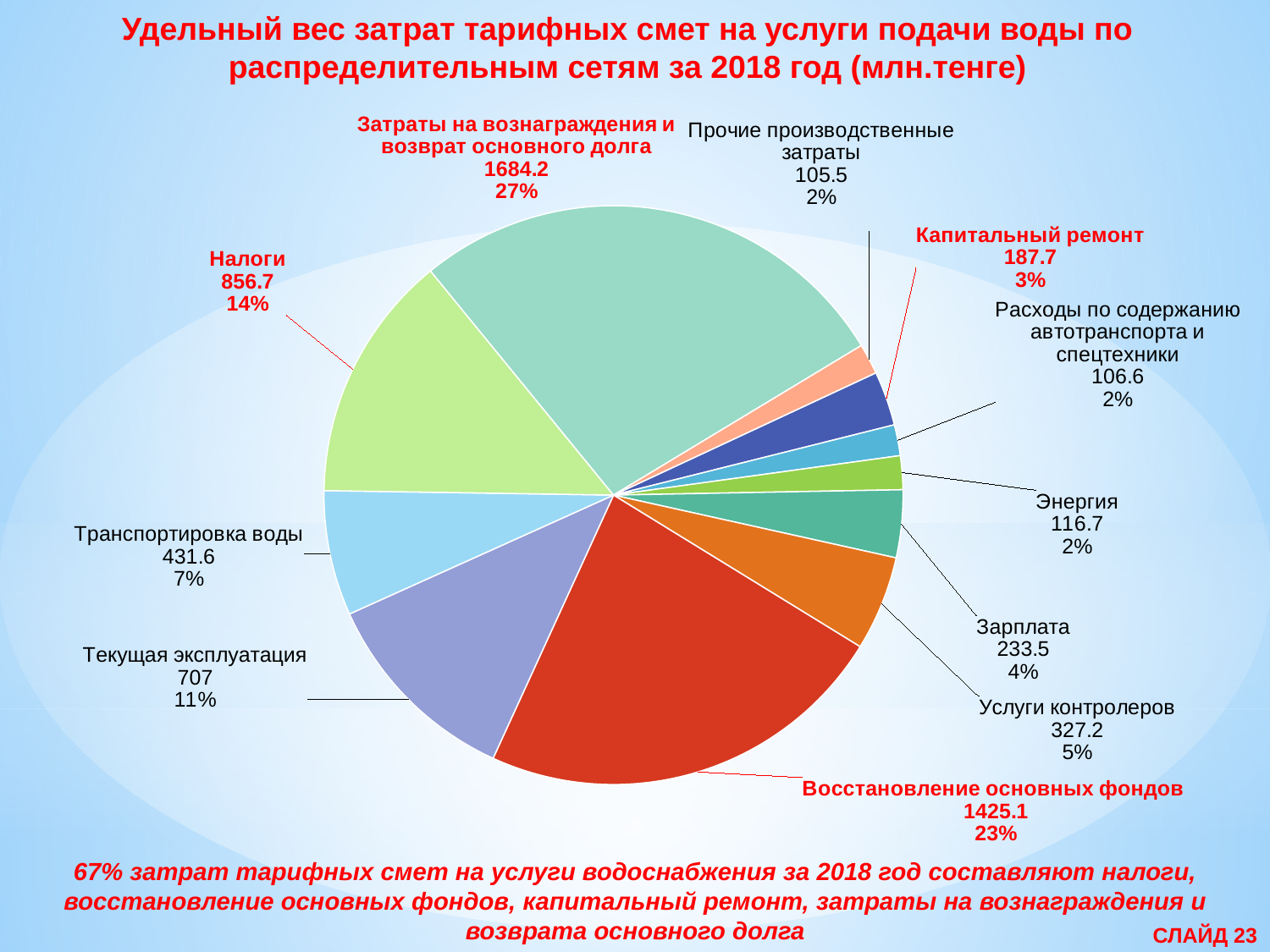
Which is larger, the value for Транспортировка воды or the value for Зарплата? Транспортировка воды What kind of chart is shown on the slide? pie chart What is the value for Капитальный ремонт? 187.7 What is the value for Восстановление основных фондов? 1425.1 What year does the chart title refer to? 2018 What is the difference between the values for Затраты на вознаграждения и возврат основного долга and Восстановление основных фондов? 259.1 What share of the pie does Услуги контролеров represent? 5% What share of the pie does Текущая эксплуатация represent? 11% Which category has the smallest value in the pie chart? Прочие производственные затраты What is the value for Налоги? 856.7 Which category has the largest share of the pie? Затраты на вознаграждения и возврат основного долга How many slices does the pie chart have? 11